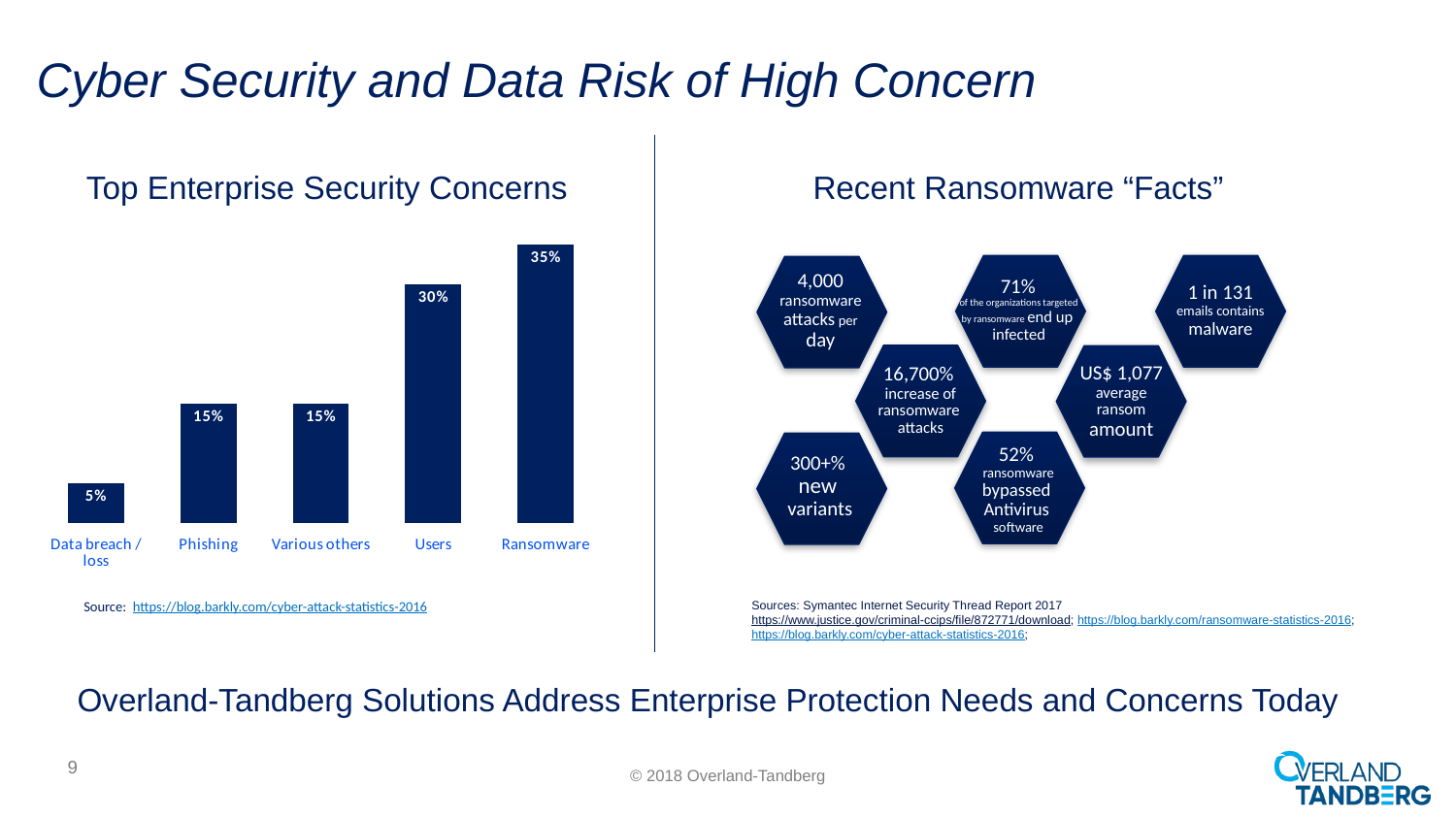
Which is larger in the Top Enterprise Security Concerns chart, Users or Various others? Users What is the difference between the values for Users and Phishing in the Top Enterprise Security Concerns chart? 15% What is the value for Data breach / loss in the Top Enterprise Security Concerns chart? 5% What is the value for Ransomware in the Top Enterprise Security Concerns chart? 35% Do the values in the Top Enterprise Security Concerns chart generally rise or fall from left to right? Rise What kind of chart is the Top Enterprise Security Concerns chart? Bar chart Which category has the lowest value in the Top Enterprise Security Concerns chart? Data breach / loss How many categories are shown in the Top Enterprise Security Concerns chart? 5 What is the value for Phishing in the Top Enterprise Security Concerns chart? 15% What is the difference between the values for Ransomware and Users in the Top Enterprise Security Concerns chart? 5% Which category has the highest value in the Top Enterprise Security Concerns chart? Ransomware What is the value for Users in the Top Enterprise Security Concerns chart? 30%